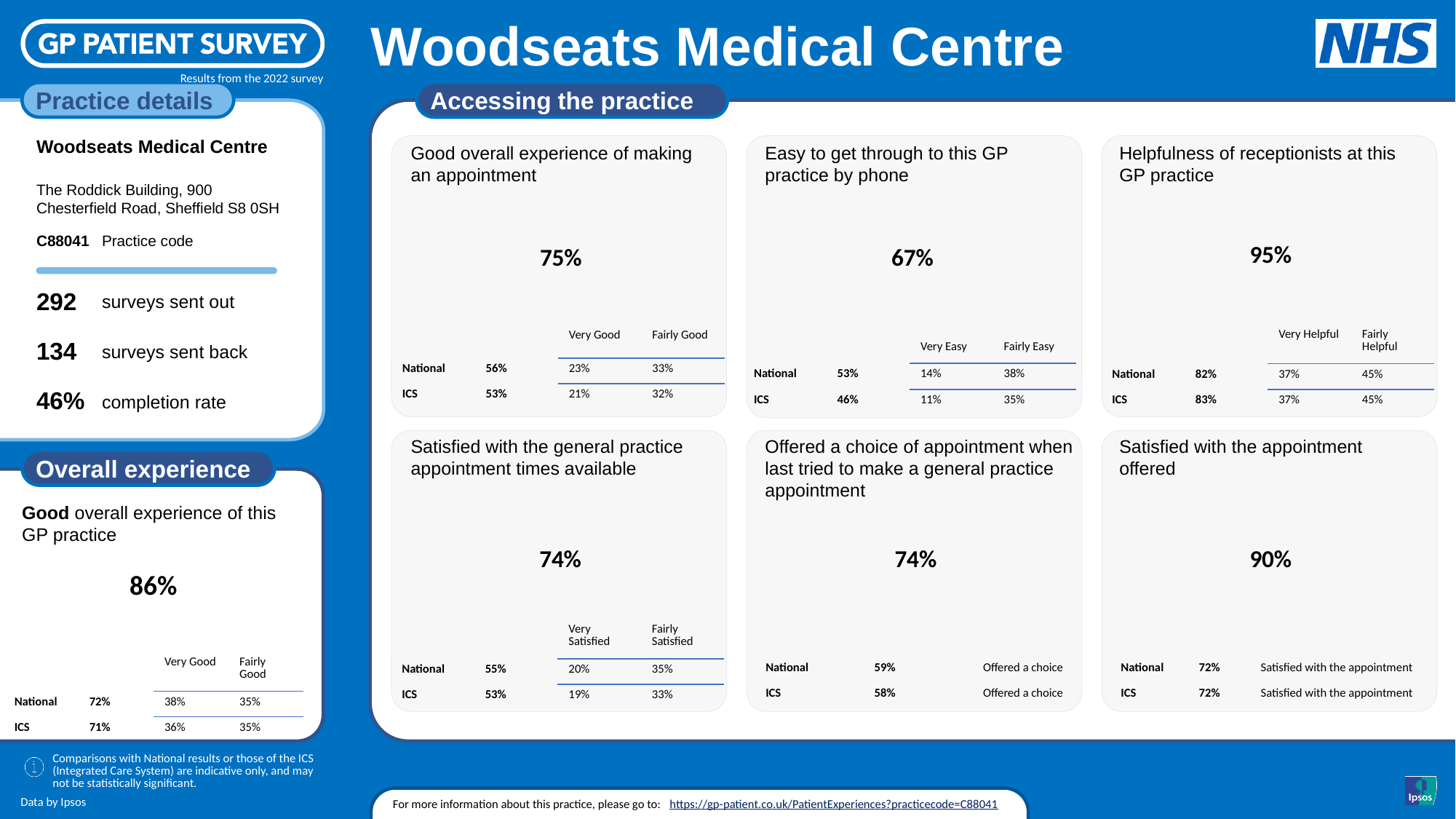
How many panels are shown in the 'Accessing the practice' section? 6 Across the six 'Accessing the practice' panels, which has the highest headline percentage? Helpfulness of receptionists at this GP practice On the 'Good overall experience of making an appointment' panel, which is larger, the National value or the ICS value? National On the 'Satisfied with the appointment offered' panel, what is the National value? 72% On the 'Satisfied with the general practice appointment times available' panel, what is the National 'Very Satisfied' percentage? 20% On the 'Easy to get through to this GP practice by phone' panel, what is the difference between the practice's headline percentage and the National value? 14% On the 'Good overall experience of making an appointment' panel, what is the practice's headline percentage? 75% On the 'Helpfulness of receptionists at this GP practice' panel, what is the ICS value? 83% On the 'Good overall experience of this GP practice' panel under Overall experience, what is the practice's headline percentage? 86% On the 'Easy to get through to this GP practice by phone' panel, what is the National value? 53% On the 'Offered a choice of appointment when last tried to make a general practice appointment' panel, what is the ICS value? 58% Across the six 'Accessing the practice' panels, which has the lowest headline percentage? Easy to get through to this GP practice by phone